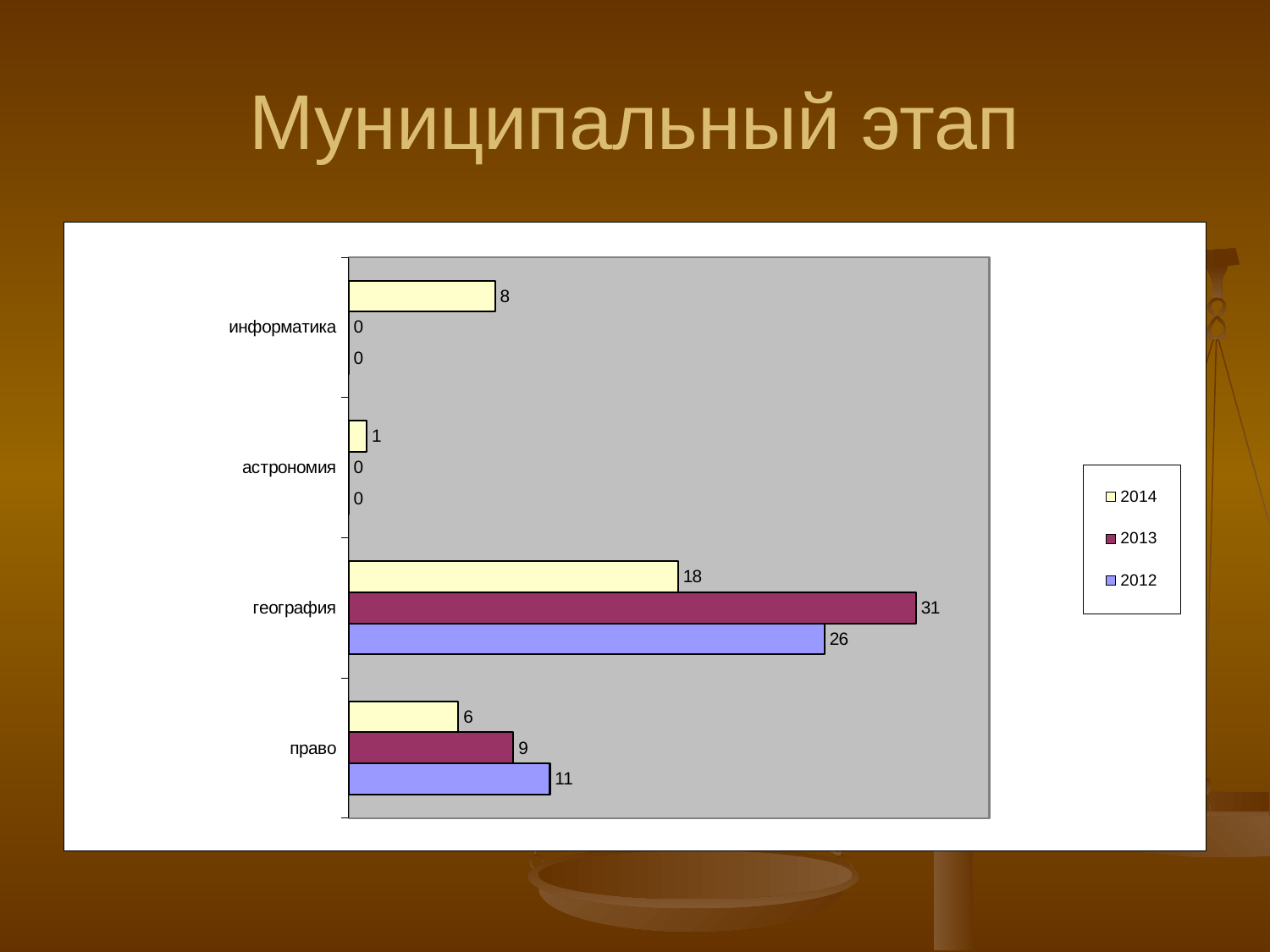
What is the value for астрономия in the 2014 series? 1 Which category has the highest value in the 2012 series? география What is the title of the slide? Муниципальный этап How many categories are shown on the chart? 4 Which is larger for право: the 2013 value or the 2012 value? 2012 How many series does the legend list? 3 What kind of chart is shown on the slide? bar chart What is the difference between the 2013 and 2014 values for география? 13 What is the value for география in the 2013 series? 31 What is the value for информатика in the 2014 series? 8 What is the value for право in the 2012 series? 11 Which category has the lowest value in the 2014 series? астрономия